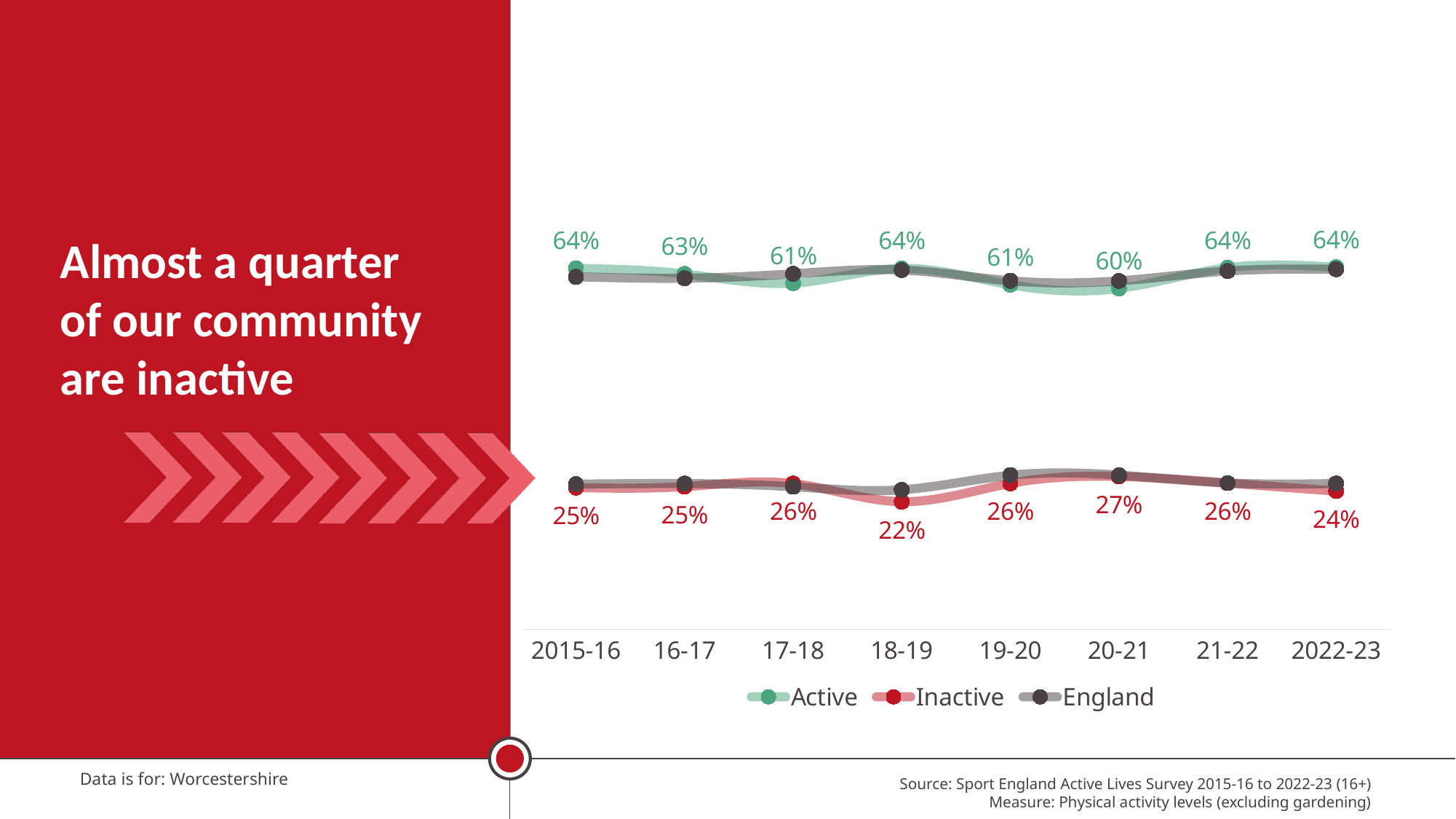
In which year is the Inactive value highest? 20-21 In which year is the Inactive value lowest? 18-19 In which year is the Active value lowest? 20-21 What kind of chart is shown on the slide? Line chart What is the Inactive value for 2022-23? 24% What is the Inactive value for 18-19? 22% How many years are shown on the x axis? 8 Which is larger, the Inactive value for 20-21 or the Inactive value for 2022-23? 20-21 What is the Active value for 2015-16? 64% How many series does the legend list? 3 What is the difference between the Active value in 2015-16 and the Active value in 20-21? 4% What is the Active value for 20-21? 60%